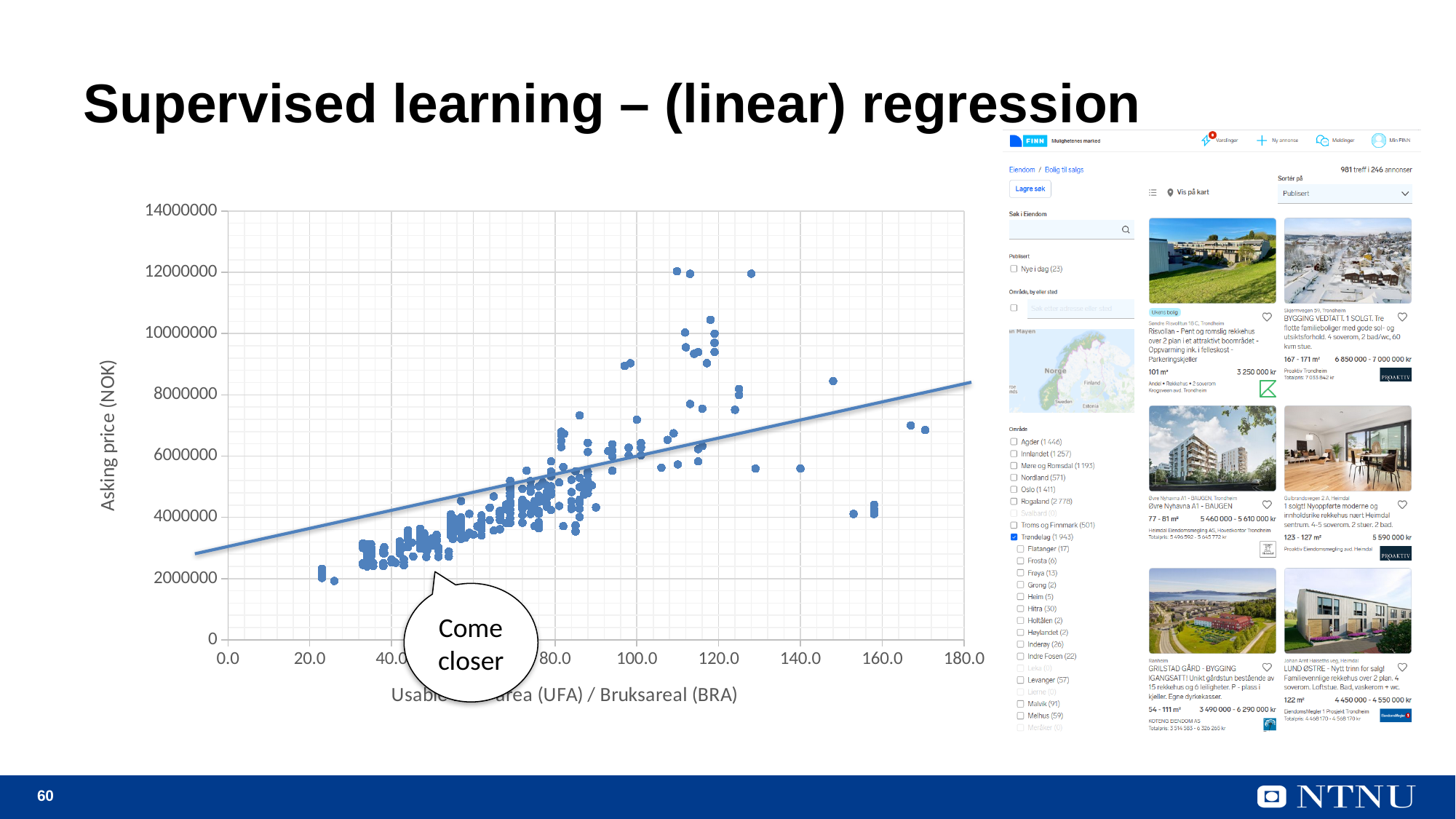
Does the fitted line in the chart slope upward or downward from left to right? upward Is the fitted line's value at a floor area of 0.0 greater or less than 4000000? less Is the fitted line's value at a floor area of 180.0 greater or less than 6000000? greater What kind of chart is shown on the slide? scatter chart As usable floor area increases along the x axis, does the asking price generally rise or fall? rise What is the label of the y axis of the chart? Asking price (NOK) Are the plotted points at a floor area of around 20 to 30 greater or less than 4000000? less What is the highest tick value shown on the x axis of the chart? 180.0